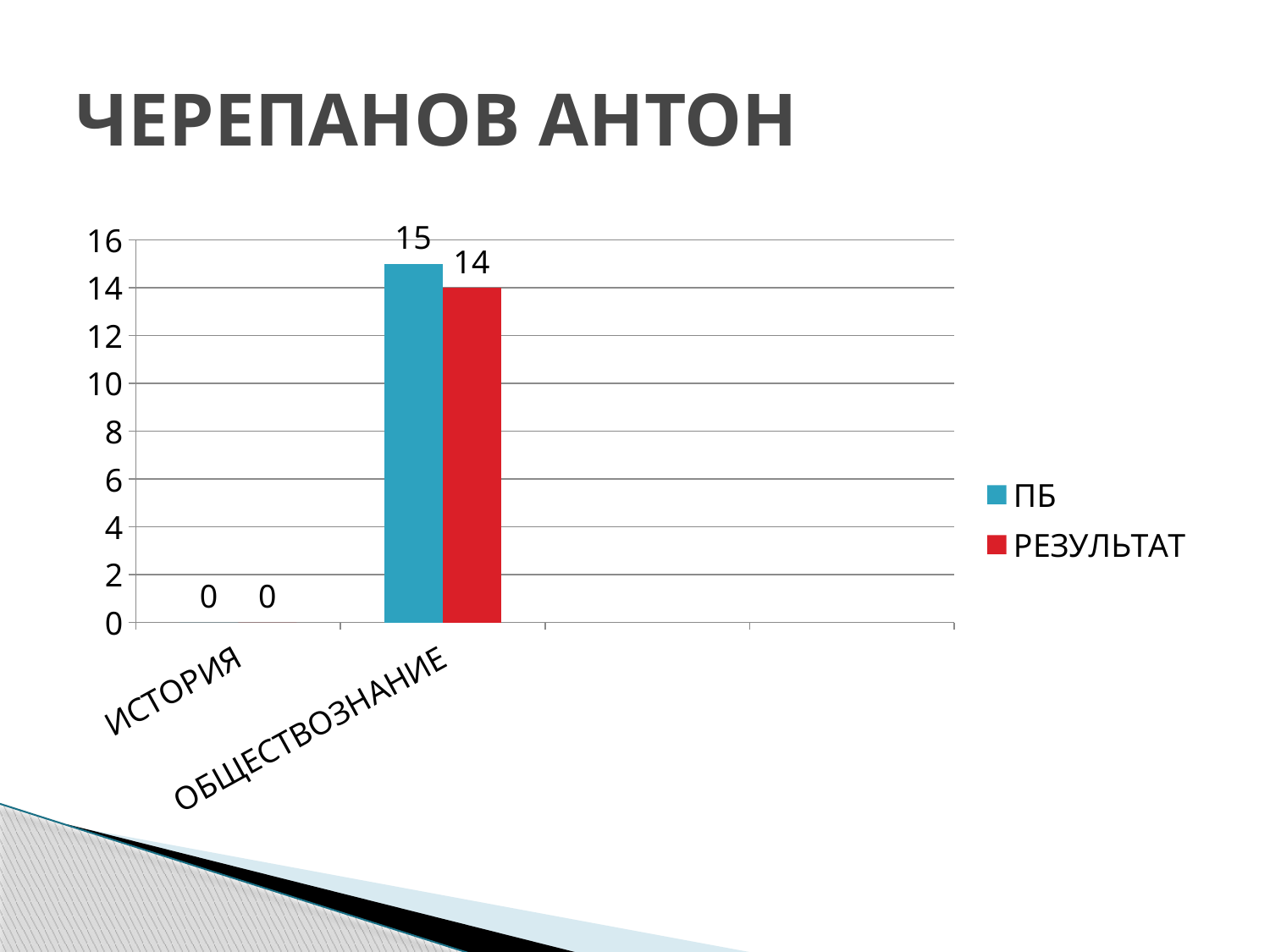
What kind of chart is shown on the slide? bar chart What is the РЕЗУЛЬТАТ value for ИСТОРИЯ? 0 Is the РЕЗУЛЬТАТ value for ОБЩЕСТВОЗНАНИЕ greater or less than 10? greater What is the title of the slide? ЧЕРЕПАНОВ АНТОН Which category has the lowest РЕЗУЛЬТАТ value? ИСТОРИЯ Which category has the highest ПБ value? ОБЩЕСТВОЗНАНИЕ What is the ПБ value for ОБЩЕСТВОЗНАНИЕ? 15 What is the РЕЗУЛЬТАТ value for ОБЩЕСТВОЗНАНИЕ? 14 What is the difference between the ПБ and РЕЗУЛЬТАТ values for ОБЩЕСТВОЗНАНИЕ? 1 What is the ПБ value for ИСТОРИЯ? 0 How many series does the legend list? 2 For ОБЩЕСТВОЗНАНИЕ, which is larger: ПБ or РЕЗУЛЬТАТ? ПБ